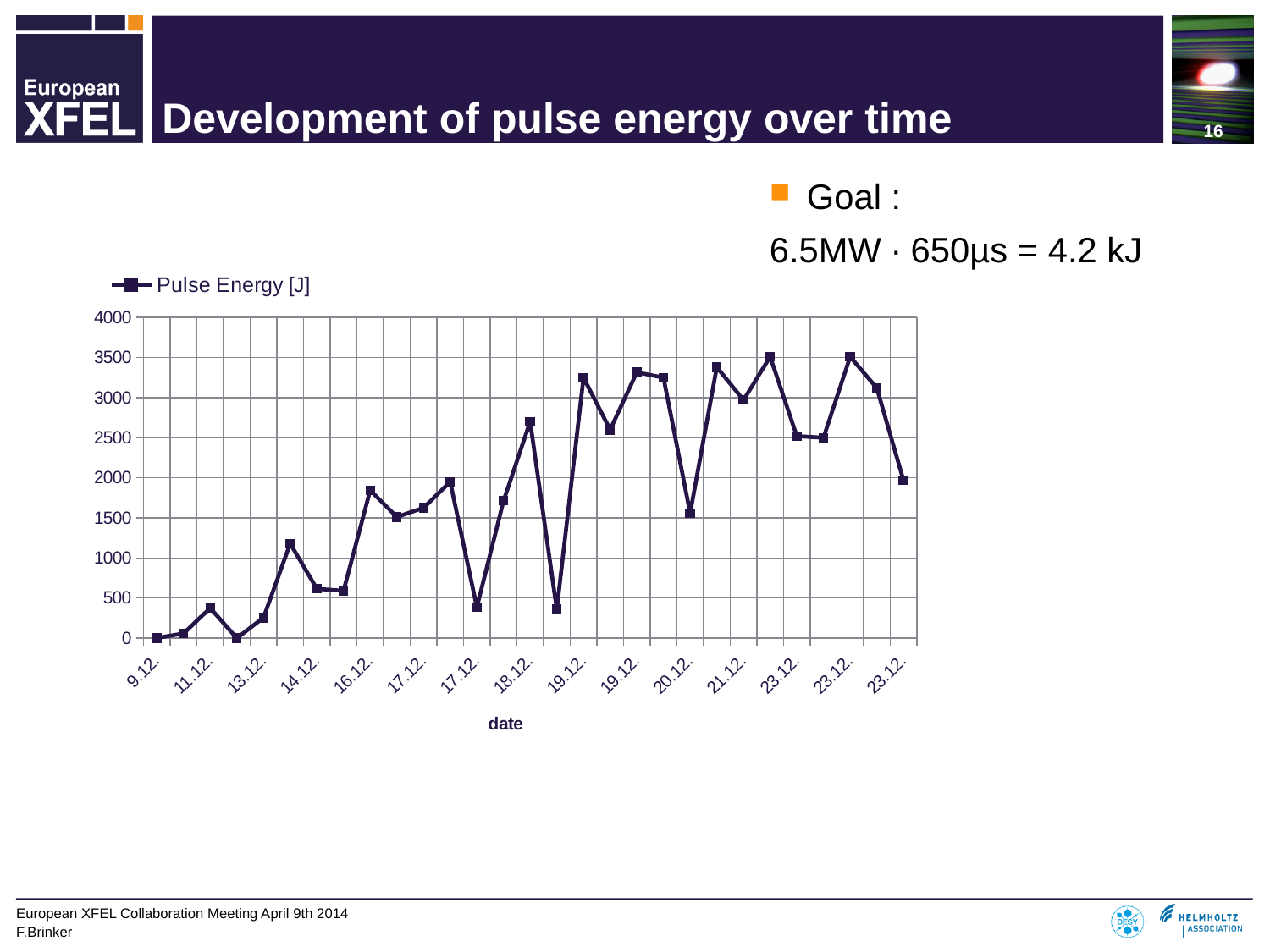
Is the value for 21.12. greater or less than 2500? greater Is the value for 16.12. greater or less than 1500? greater Does the pulse energy generally rise or fall from 9.12. to 21.12.? rise Is the value for 18.12. greater or less than 2000? greater What kind of chart is shown on the slide? line chart Which has the larger pulse energy, 20.12. or 21.12.? 21.12. How many series does the legend list? 1 Which has the larger pulse energy, 14.12. or 16.12.? 16.12. What is the name of the series shown in the legend? Pulse Energy [J] What is the title of the x axis? date